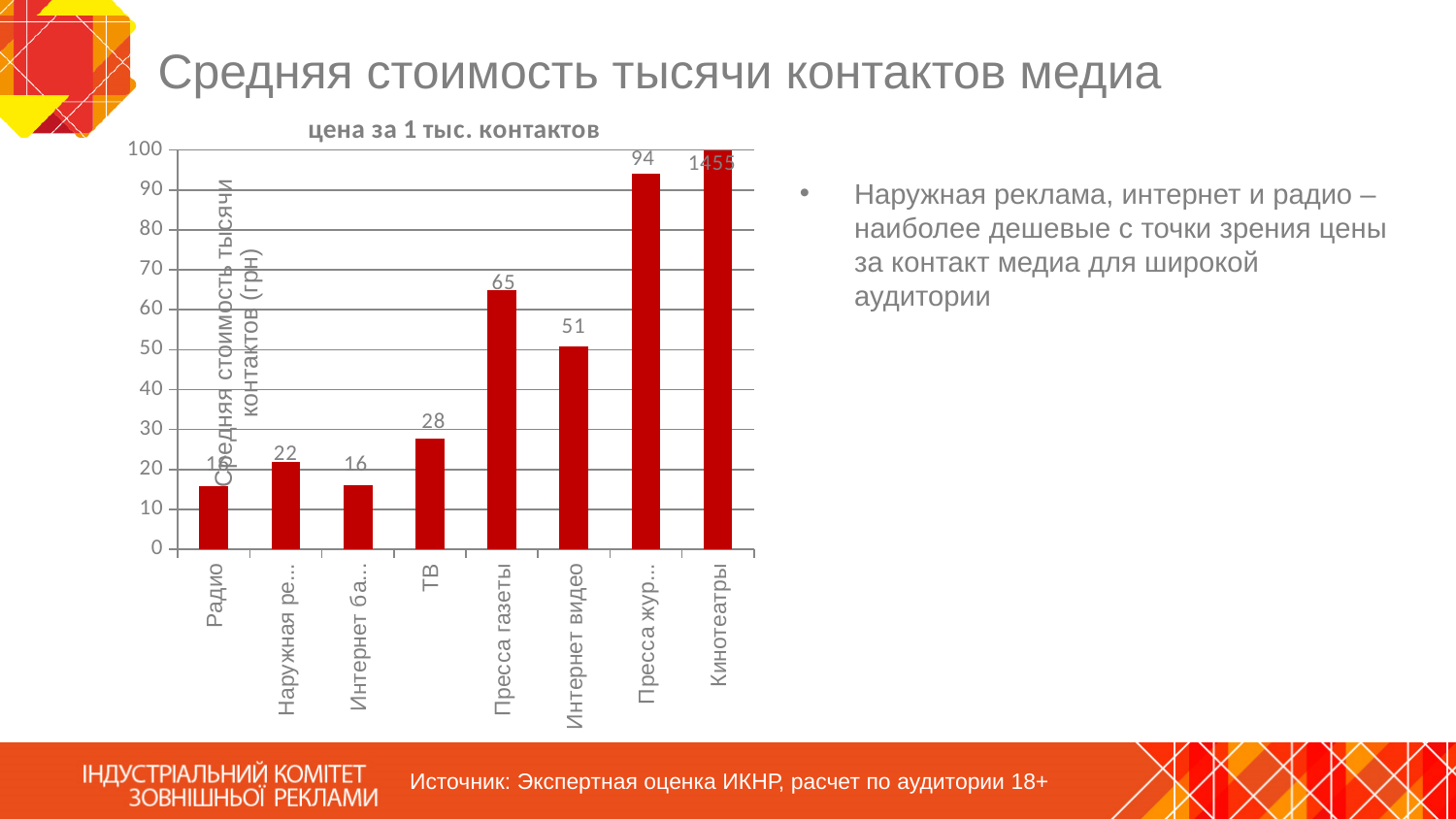
Which is larger, the value for ТВ or the value for Интернет видео? Интернет видео What is the difference between the values for Пресса газеты and ТВ? 37 How many categories are shown on the x axis of the chart? 8 What is the value for ТВ in the chart? 28 What is the value for Пресса газеты? 65 Is the value for Радио greater or less than 20? less What is the difference between the values for Пресса газеты and Интернет видео? 14 What kind of chart is shown on the slide? bar chart What is the value for Кинотеатры? 1455 What is the value for Интернет видео? 51 Which category has the highest value in the chart? Кинотеатры What is the title of the chart? цена за 1 тыс. контактов